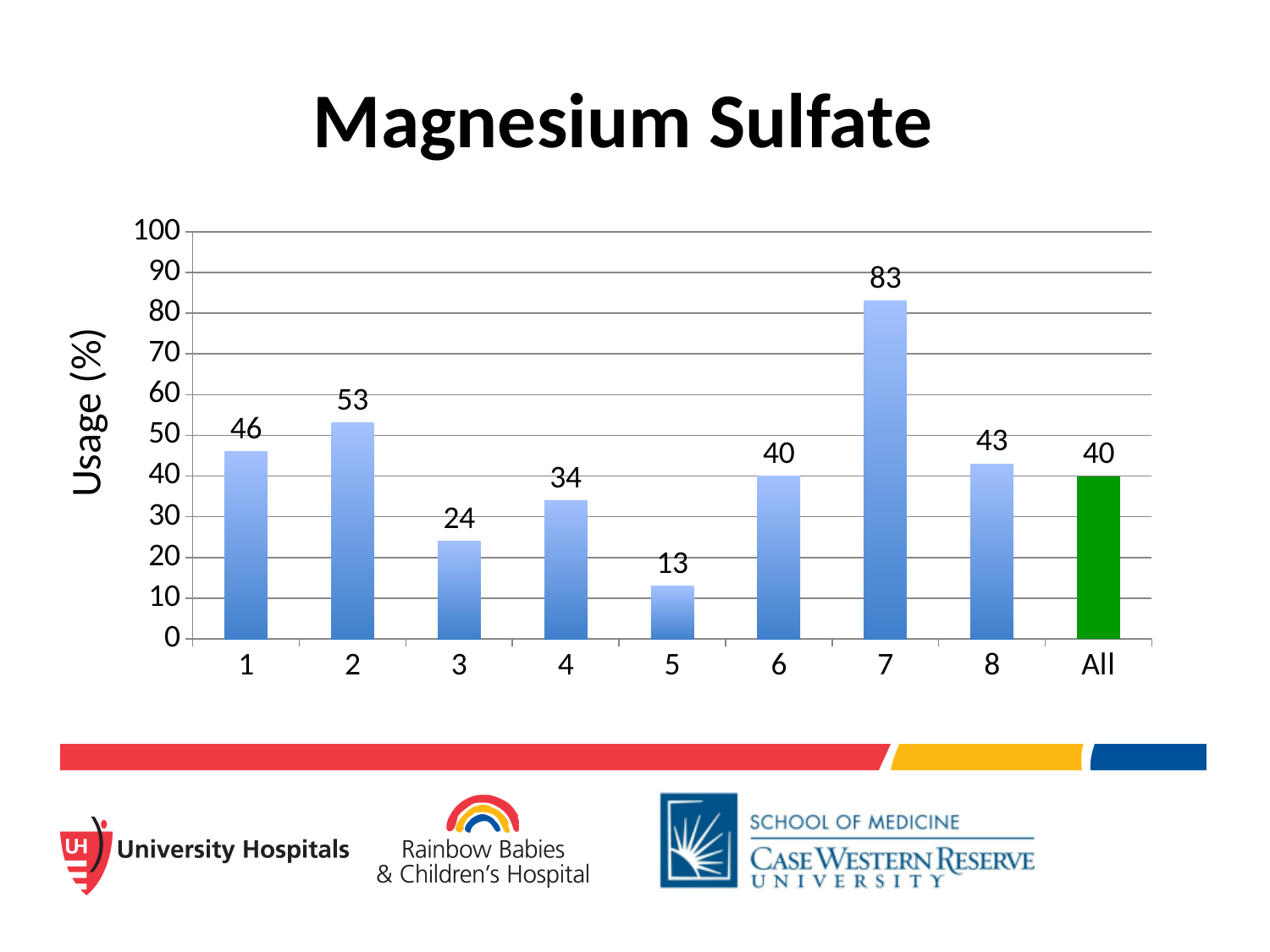
Which has higher usage, category 4 or category 8? 8 What is the usage (%) for category 7? 83 How many categories are shown on the x axis? 9 What is the difference in usage between category 2 and category 1? 7 What kind of chart is shown on the slide? bar chart What is the difference in usage between category 7 and category 5? 70 Which category has the highest usage? 7 What is the usage (%) for the 'All' category? 40 What is the title of the chart? Magnesium Sulfate Is the value for category 7 greater or less than 80? greater Which category has the lowest usage? 5 What is the usage (%) for category 3? 24